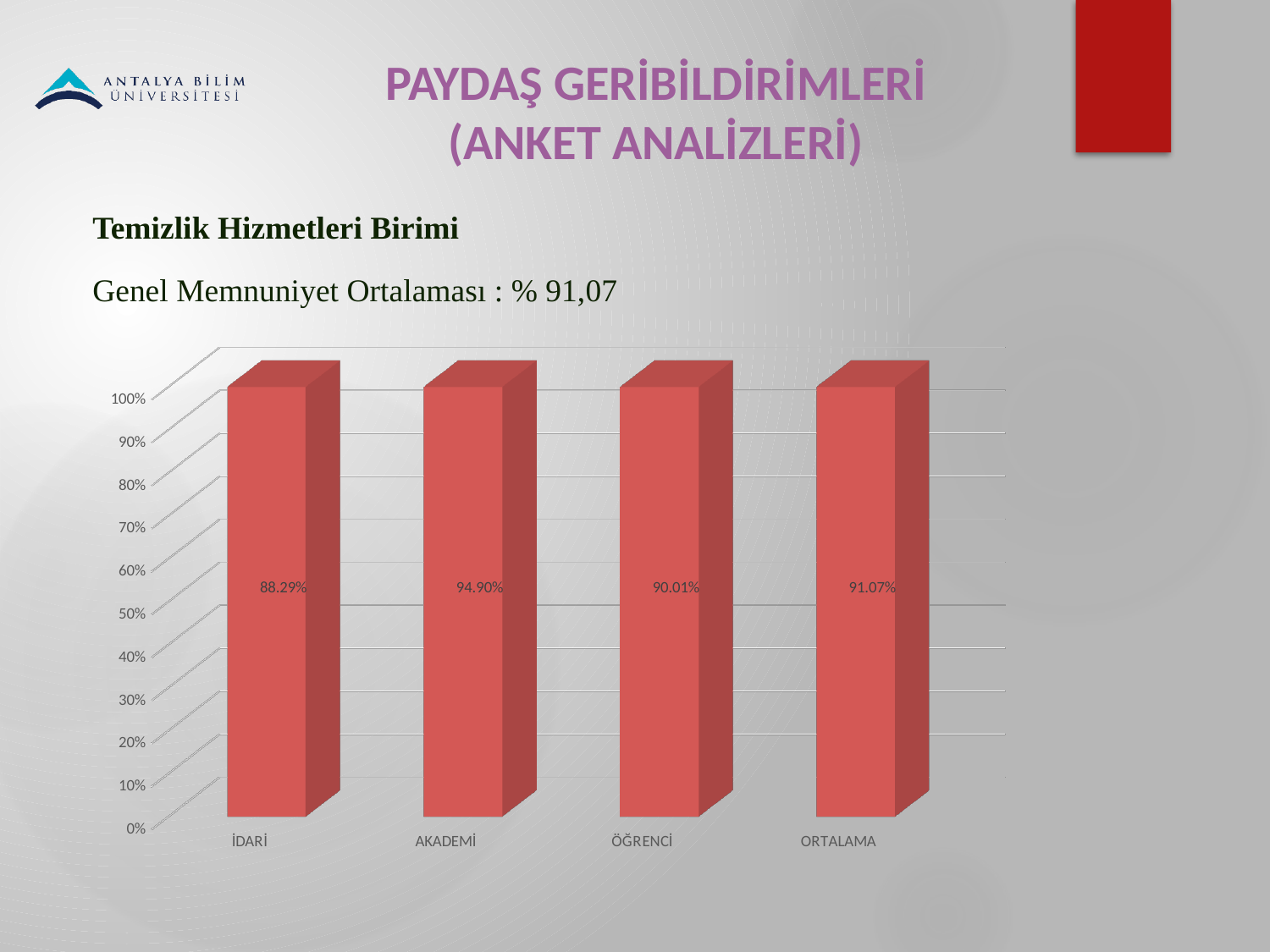
What is the difference between the AKADEMİ and İDARİ values? 6.61 percentage points Which category has the lowest value? İDARİ How many categories are shown on the x axis? 4 Which category has the highest value? AKADEMİ What is the highest value shown on the y axis? 100% What is the value for AKADEMİ? 94.90% What is the value for ORTALAMA? 91.07% What is the value for İDARİ? 88.29% Which is larger, the value for ÖĞRENCİ or the value for İDARİ? ÖĞRENCİ What kind of chart is shown on the slide? Bar chart What is the value for ÖĞRENCİ? 90.01% What is the difference between the ORTALAMA and ÖĞRENCİ values? 1.06 percentage points